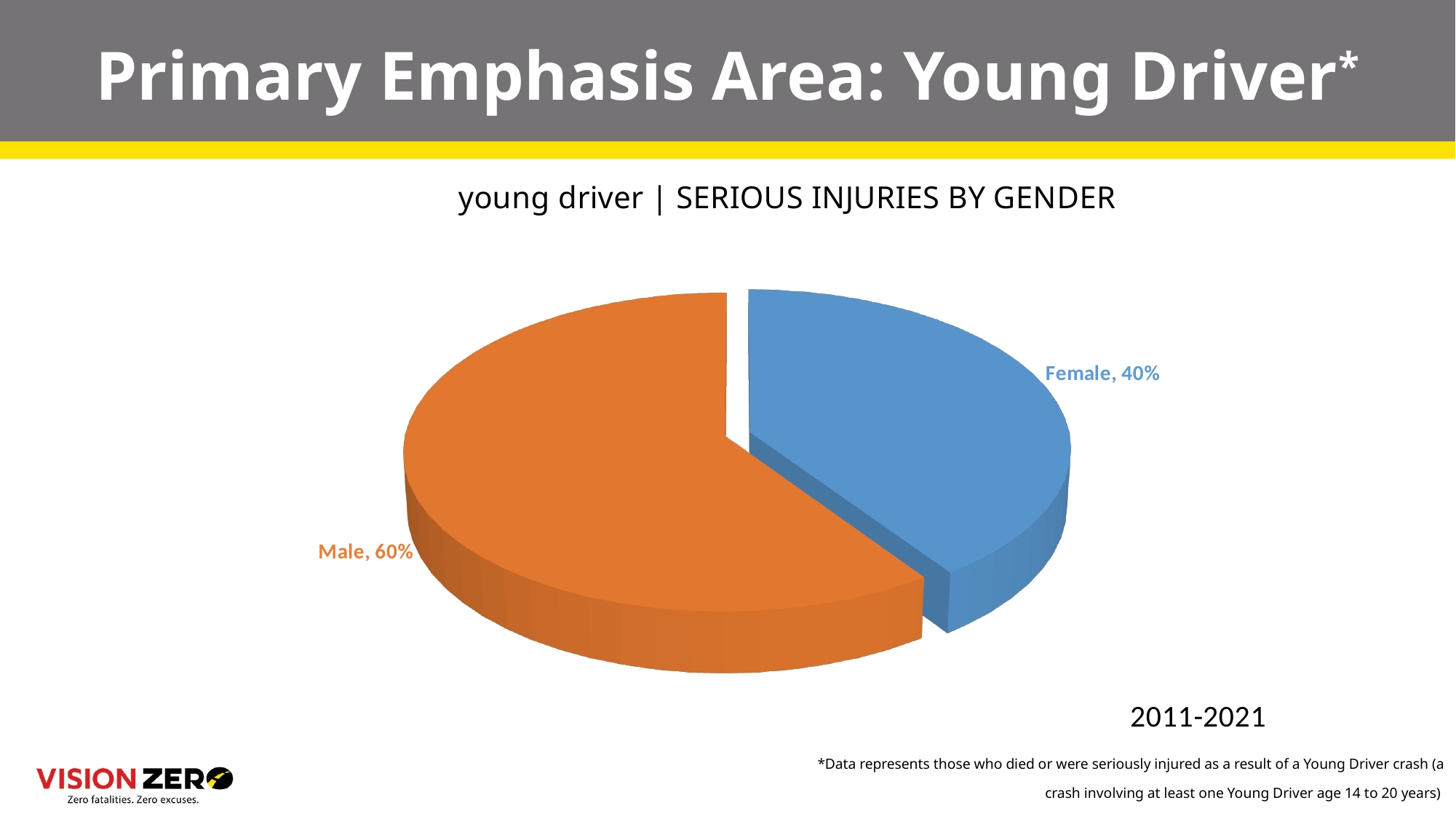
What is the title of the chart? young driver | SERIOUS INJURIES BY GENDER What share of young driver serious injuries is Male? 60% Which gender has the larger share of young driver serious injuries? Male What kind of chart is shown on the slide? Pie chart What time period does the chart cover? 2011-2021 Is the Male share larger or smaller than the Female share? Larger How many slices does the pie chart have? 2 What is the difference in percentage points between the Male and Female shares? 20 percentage points Which gender has the smaller share of young driver serious injuries? Female What colour is the Female slice of the pie chart? Blue What share of young driver serious injuries is Female? 40%